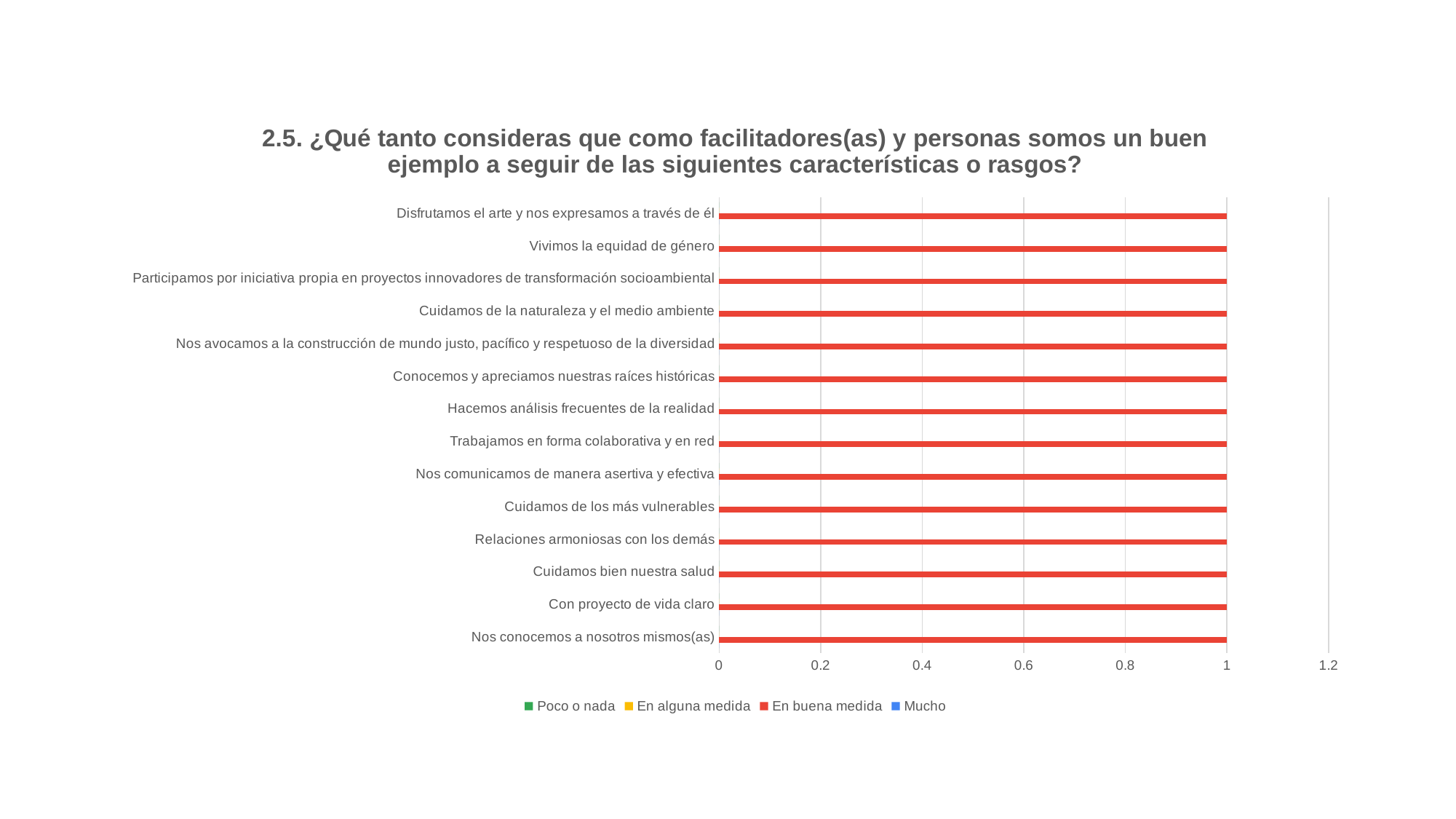
What is the highest value shown on the horizontal axis? 1.2 What is the value of the 'En buena medida' bar for 'Vivimos la equidad de género'? 1 Is the 'En buena medida' value for 'Trabajamos en forma colaborativa y en red' greater or less than 0.8? greater What kind of chart is shown on the slide? Bar chart What is the value of the 'En buena medida' bar for 'Nos conocemos a nosotros mismos(as)'? 1 Which legend entry corresponds to the red bars in the chart? En buena medida Is the 'En buena medida' value for 'Cuidamos de los más vulnerables' greater or less than 1.2? less What is the value of the 'En buena medida' bar for 'Cuidamos bien nuestra salud'? 1 How many categories are listed on the vertical axis of the chart? 14 How many series does the legend list? 4